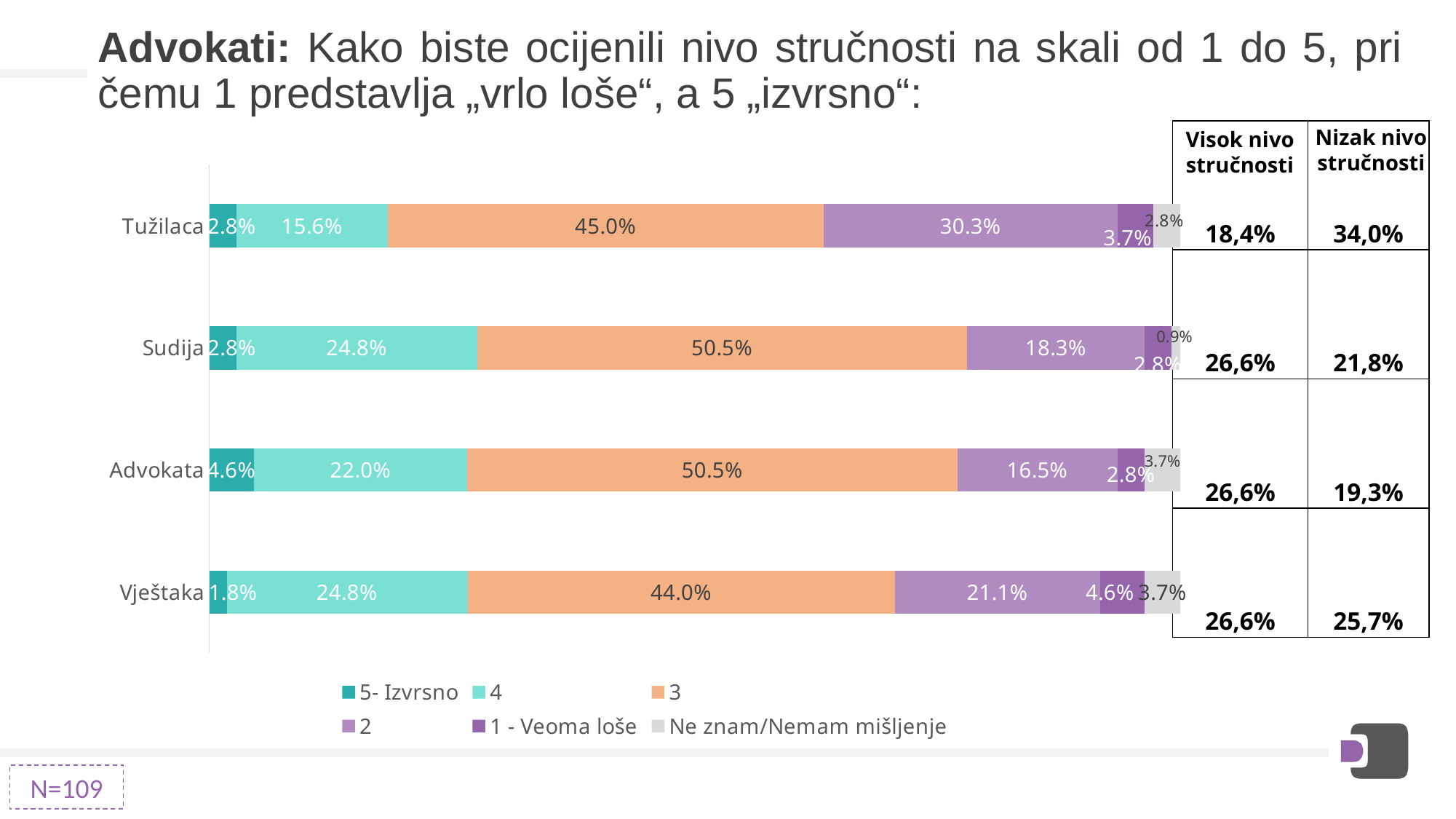
What is the label of the last series in the legend? Ne znam/Nemam mišljenje Which category has the lowest value for the '5- Izvrsno' series? Vještaka What kind of chart is shown on the slide? Stacked bar chart What is the difference between the '3' series values for Sudija and Vještaka? 6.5% What is the value of the '5- Izvrsno' series for Advokata? 4.6% What is the value of the '3' series for Tužilaca? 45.0% Which is larger: the '4' series value for Tužilaca or for Advokata? Advokata What is the value of the '4' series for Sudija? 24.8% Which category has the highest value for the '2' series? Tužilaca How many categories are plotted on the chart? 4 How many series does the chart legend list? 6 What is the value of the '2' series for Vještaka? 21.1%